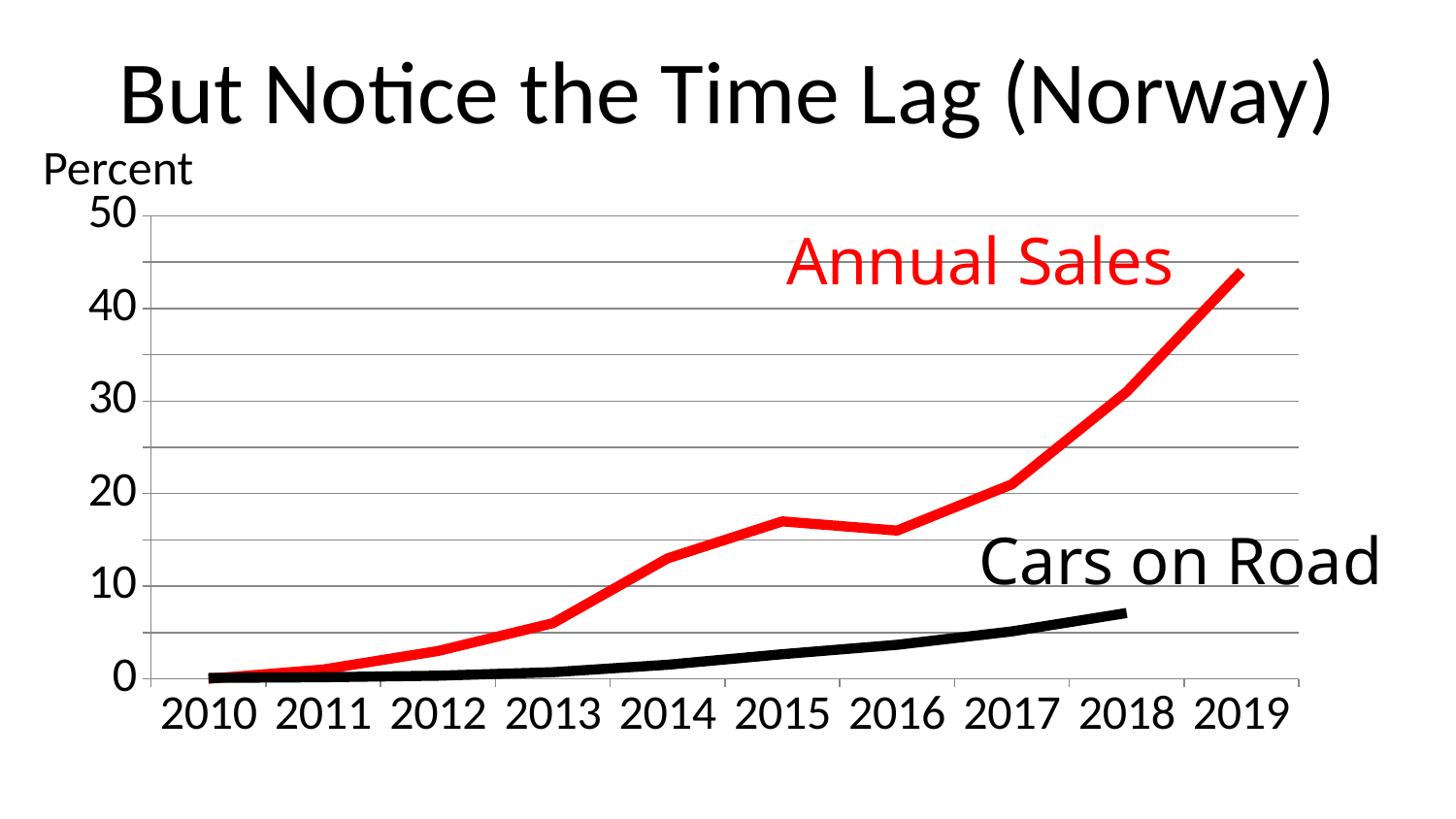
In 2018, which series has the higher value, Annual Sales or Cars on Road? Annual Sales How many years are labelled along the x axis? 10 Does the Cars on Road series rise or fall from 2010 to 2018? rise How many data series are plotted on the chart? 2 What colour is the Annual Sales line? red Is the Annual Sales value for 2019 greater or less than 40? greater Is the Annual Sales value for 2014 greater or less than 10? greater What is the label on the vertical axis of the chart? Percent Is the Annual Sales value for 2017 greater or less than 30? less What kind of chart is shown on the slide? line chart In which year does the Annual Sales series reach its highest value? 2019